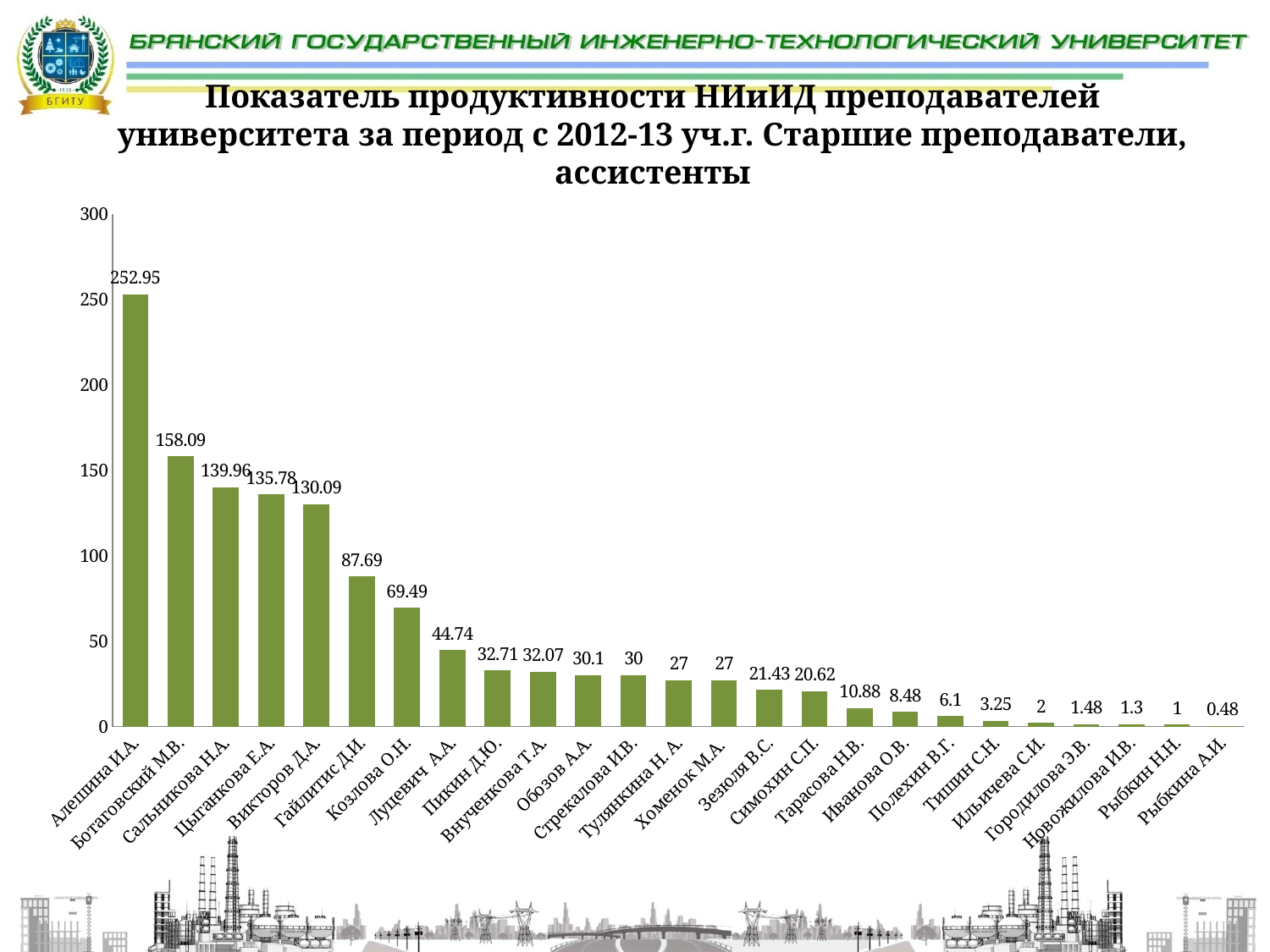
Do the values rise or fall from left to right along the x axis? fall What is the value for Зезюля В.С.? 21.43 Is the value for Викторов Д.А. greater or less than 100? greater Which category has the lowest value? Рыбкина А.И. What kind of chart is shown on the slide? bar chart What is the value for Гайлитис Д.И.? 87.69 How many categories are shown on the x axis? 25 Which category has the highest value? Алешина И.А. What is the value for Алешина И.А.? 252.95 Which is larger, the value for Козлова О.Н. or the value for Луцевич А.А.? Козлова О.Н. What is the value for Тарасова Н.В.? 10.88